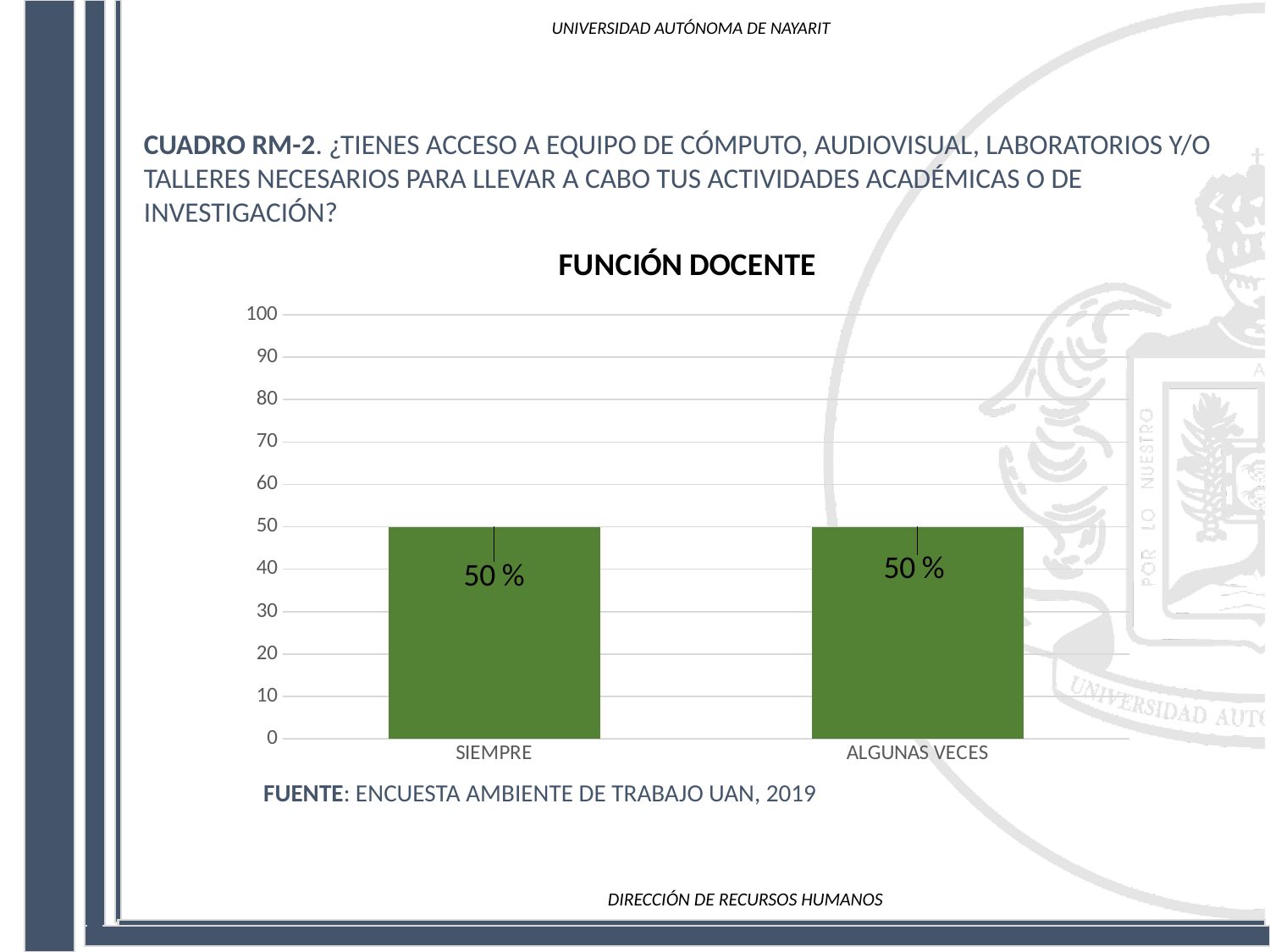
What is the highest value shown on the y axis? 100 What is the value for ALGUNAS VECES? 50 % What kind of chart is shown on the slide? bar chart What is the total of the two bars' values? 100 % What is the title of the chart? FUNCIÓN DOCENTE Is the value for ALGUNAS VECES greater or less than 40? greater What is the difference between the values for SIEMPRE and ALGUNAS VECES? 0 Is the value for SIEMPRE greater or less than 60? less What is the value for SIEMPRE? 50 % How many categories are shown on the x axis? 2